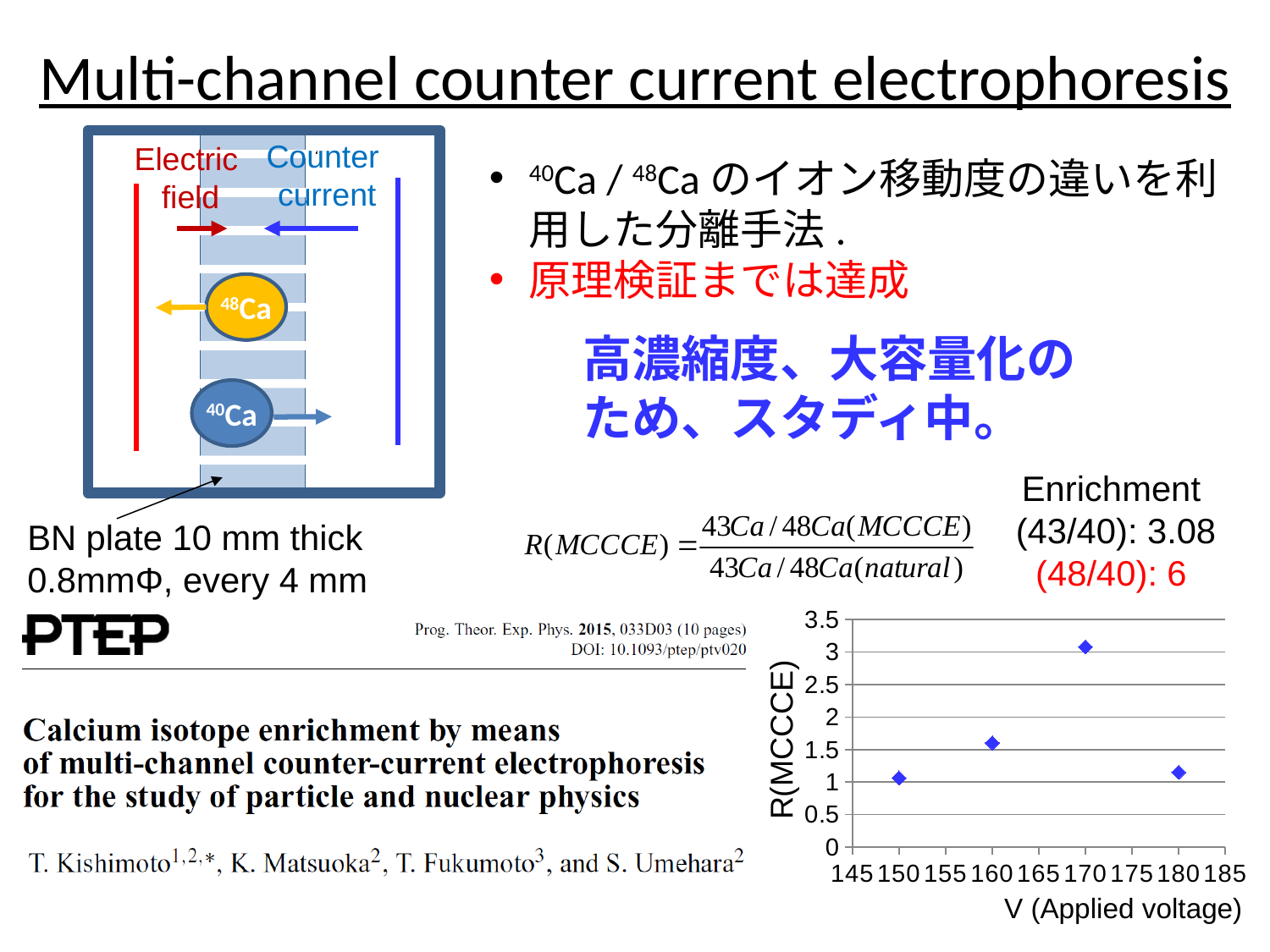
Is the value of R(MCCCE) at 150 V greater or less than 1.5? less Is R(MCCCE) larger at 160 V or at 170 V? 170 V Is the value of R(MCCCE) at 160 V greater or less than 2? less What kind of chart is shown at the bottom right of the slide? scatter chart Is the value of R(MCCCE) at 180 V greater or less than 2? less How many data points are plotted in the R(MCCCE) chart? 4 Is R(MCCCE) larger at 150 V or at 160 V? 160 V At which applied voltage is R(MCCCE) highest? 170 What is the label of the x axis of the chart? V (Applied voltage) What is the label of the y axis of the chart? R(MCCCE) Does R(MCCCE) rise or fall between 170 V and 180 V? fall